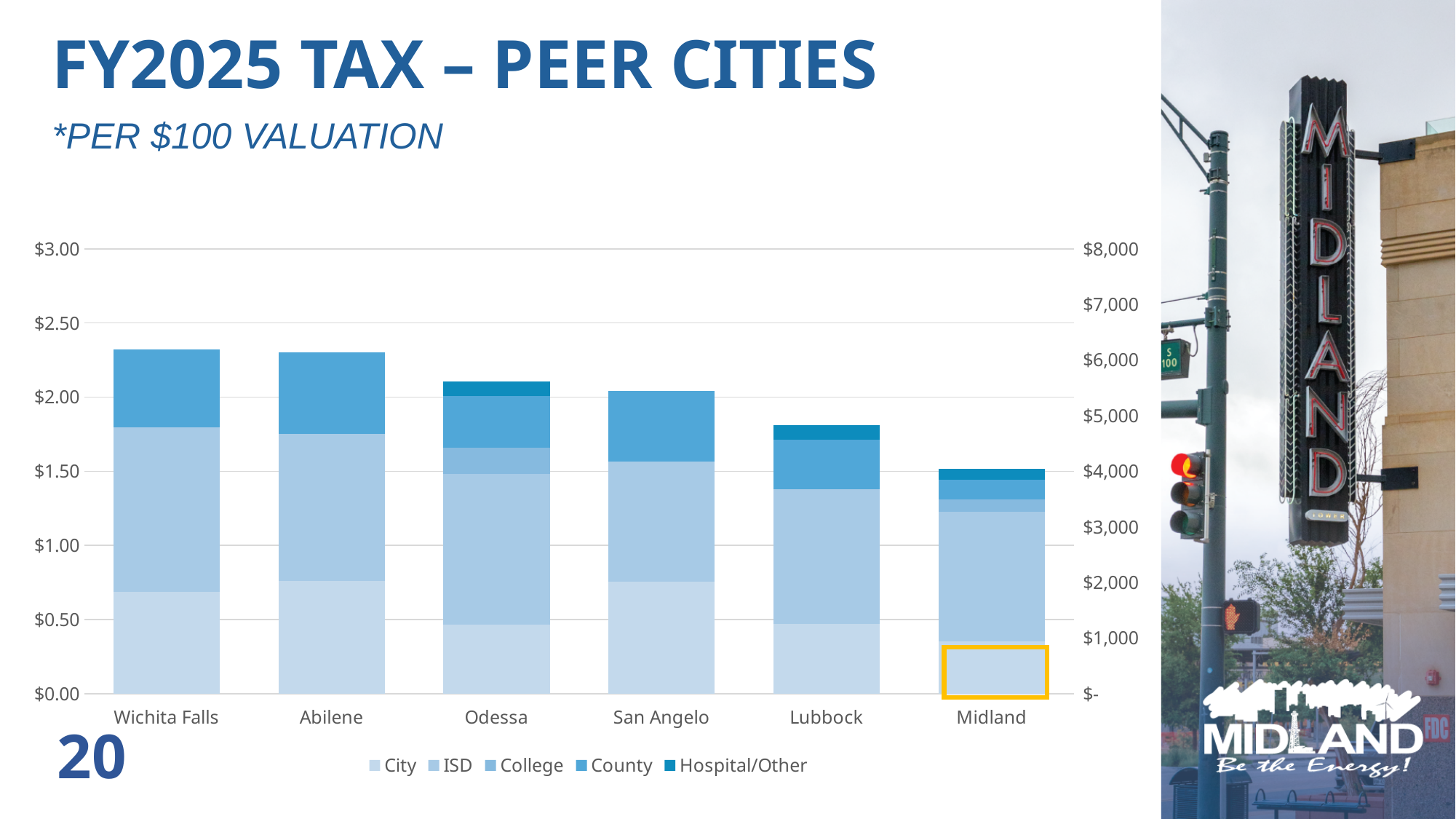
Is the City portion of the tax rate for Wichita Falls greater or less than $0.50? greater Which city has the lowest total tax rate in the chart? Midland How many cities are shown on the x axis of the chart? 6 Is the City portion of the tax rate for Midland greater or less than $0.50? less Is the total tax rate for Midland greater or less than $2.00? less How many series does the chart's legend list? 5 Which series are listed in the chart's legend? City, ISD, College, County, Hospital/Other Do the total tax rates generally rise or fall moving from Wichita Falls to Midland along the x axis? Fall What kind of chart is shown on the slide? Stacked bar chart Which city has the larger total tax rate, Lubbock or Midland? Lubbock